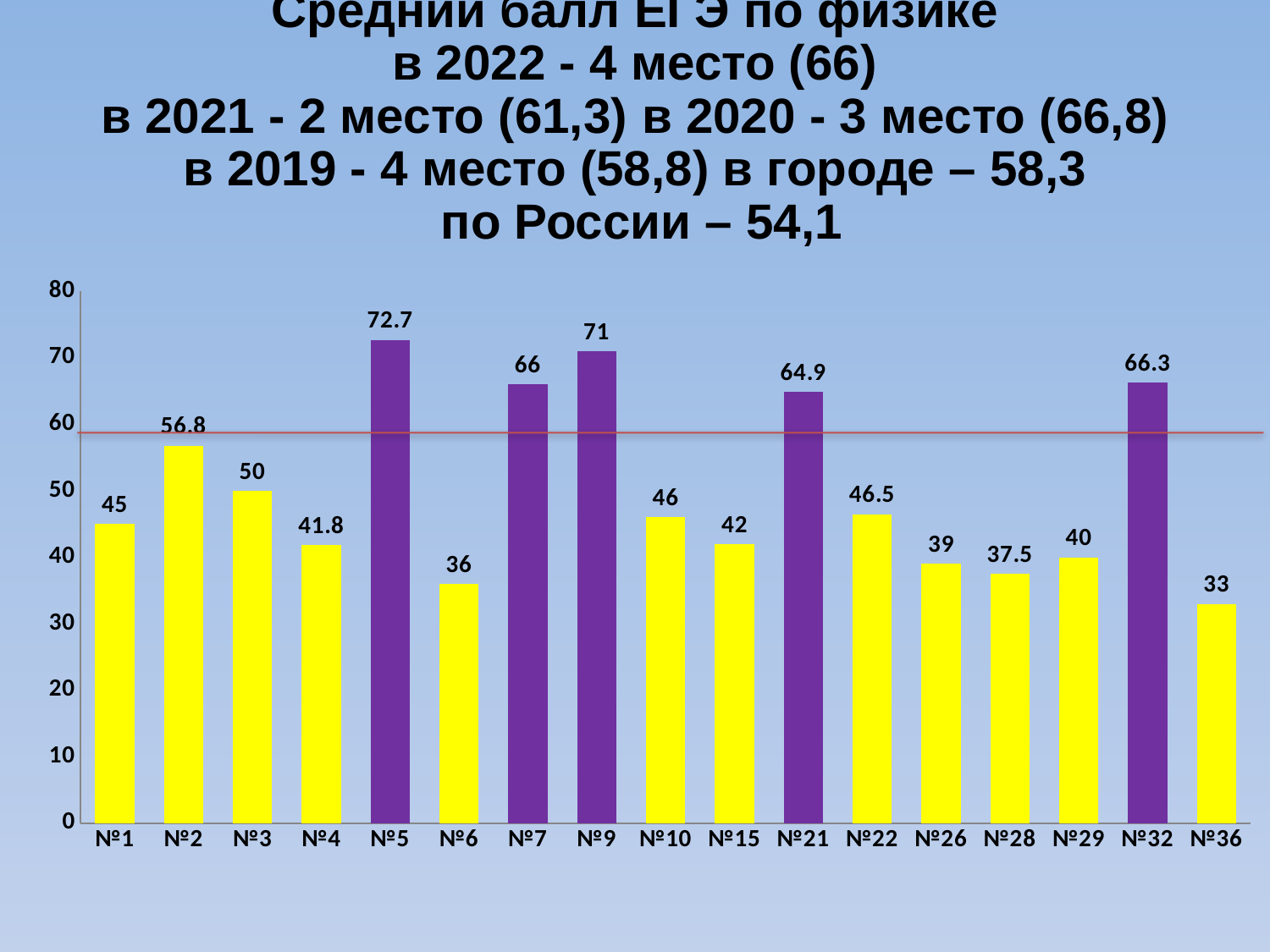
Is the value for №32 greater or less than 60? greater Which category has the lowest value? №36 What kind of chart is shown on the slide? bar chart How many bars are coloured purple? 5 What is the value for №5? 72.7 How many categories are shown on the x axis? 17 Which category has the highest value? №5 Which is larger, the value for №22 or the value for №10? №22 What is the difference between the values for №2 and №6? 20.8 What is the value for №21? 64.9 What is the difference between the values for №9 and №7? 5 What is the value for №28? 37.5